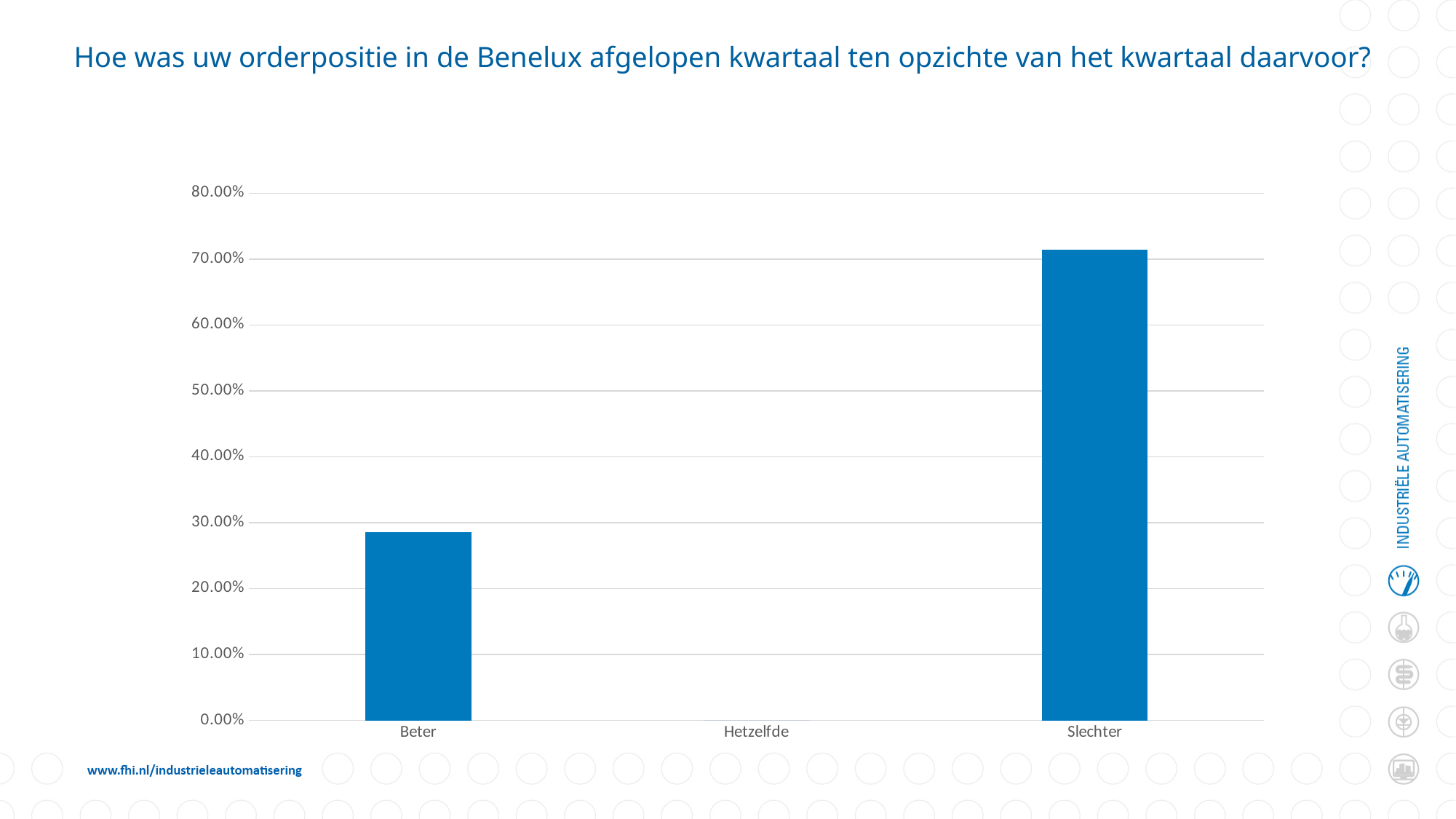
What kind of chart is shown on the slide? bar chart Is the value for Slechter greater or less than 60.00%? greater Which is larger, the value for Beter or the value for Slechter? Slechter What is the highest value labelled on the y axis of the chart? 80.00% Is the value for Slechter greater or less than 80.00%? less Is the value for Beter greater or less than 20.00%? greater Which category has the lowest value in the chart? Hetzelfde Which category has the highest value in the chart? Slechter What is the value for Hetzelfde in the chart? 0.00% What is the title of the chart on the slide? Hoe was uw orderpositie in de Benelux afgelopen kwartaal ten opzichte van het kwartaal daarvoor? How many categories are shown on the x axis of the chart? 3